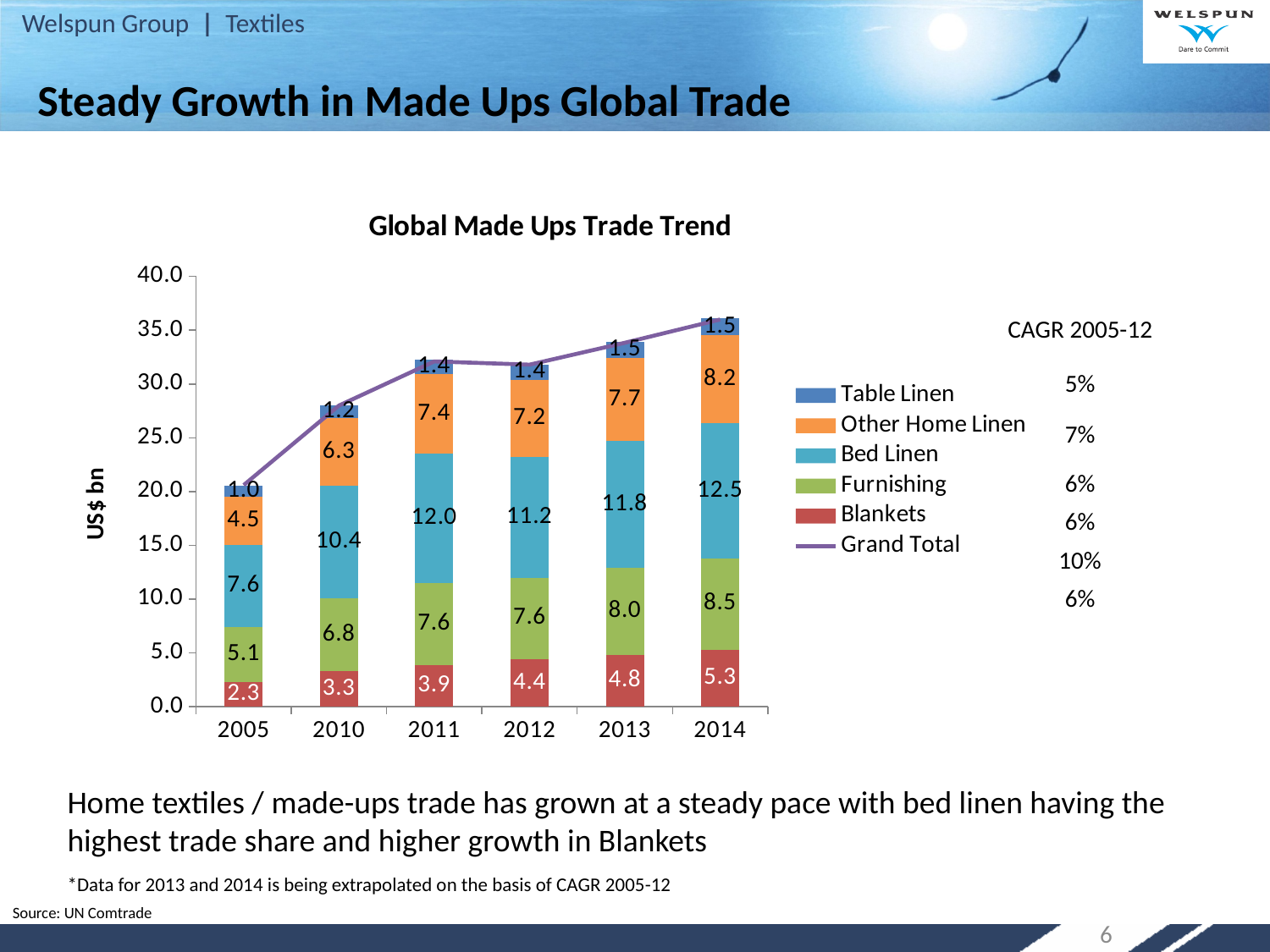
What is the value for Bed Linen in 2014? 12.5 What is the value for Other Home Linen in 2011? 7.4 How many years are shown on the x axis? 6 How many series does the legend list? 6 What is the total of the stacked bar for 2005? 20.5 What kind of chart is this? Stacked bar chart with a line What is the value for Blankets in 2005? 2.3 Which is larger, Bed Linen in 2011 or Bed Linen in 2012? Bed Linen in 2011 What is the title of the chart? Global Made Ups Trade Trend In which year is the Blankets value highest? 2014 What is the difference between the Furnishing values in 2014 and 2005? 3.4 In which year is the Bed Linen value lowest? 2005